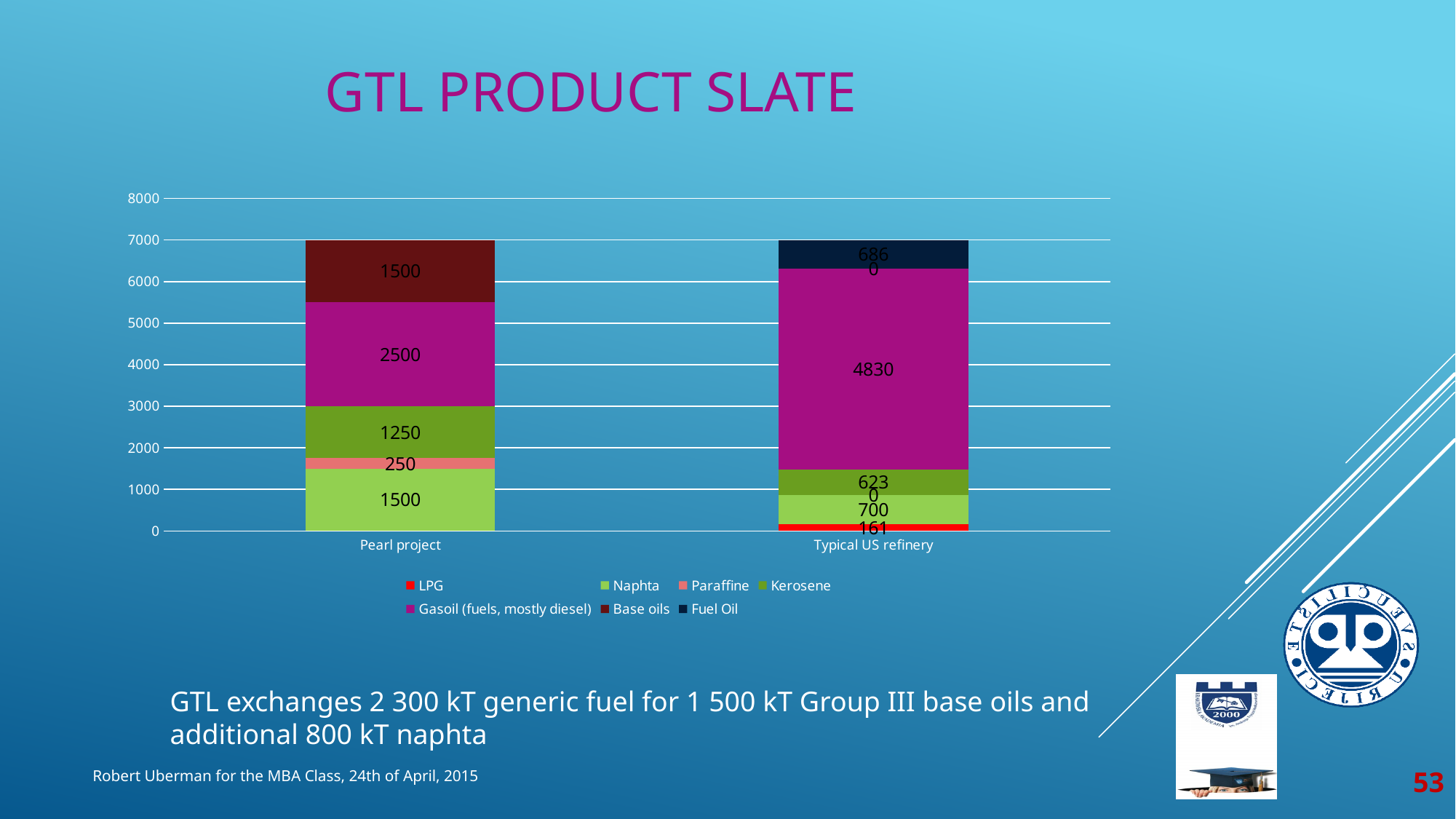
How many series does the chart's legend list? 7 What is the value of Fuel Oil for the Typical US refinery? 686 What is the total of the stacked bar for the Typical US refinery? 7000 What is the value of LPG for the Typical US refinery? 161 What is the value of Kerosene for the Pearl project? 1250 What is the value of Gasoil (fuels, mostly diesel) for the Typical US refinery? 4830 Which has the larger Naphta value, the Pearl project or the Typical US refinery? Pearl project What is the value of Base oils for the Pearl project? 1500 Which series has the largest segment in the Pearl project bar? Gasoil (fuels, mostly diesel) How many categories are shown on the x axis of the chart? 2 What is the difference between the Gasoil value for the Typical US refinery and the Gasoil value for the Pearl project? 2330 What kind of chart is shown on the slide? Stacked bar chart